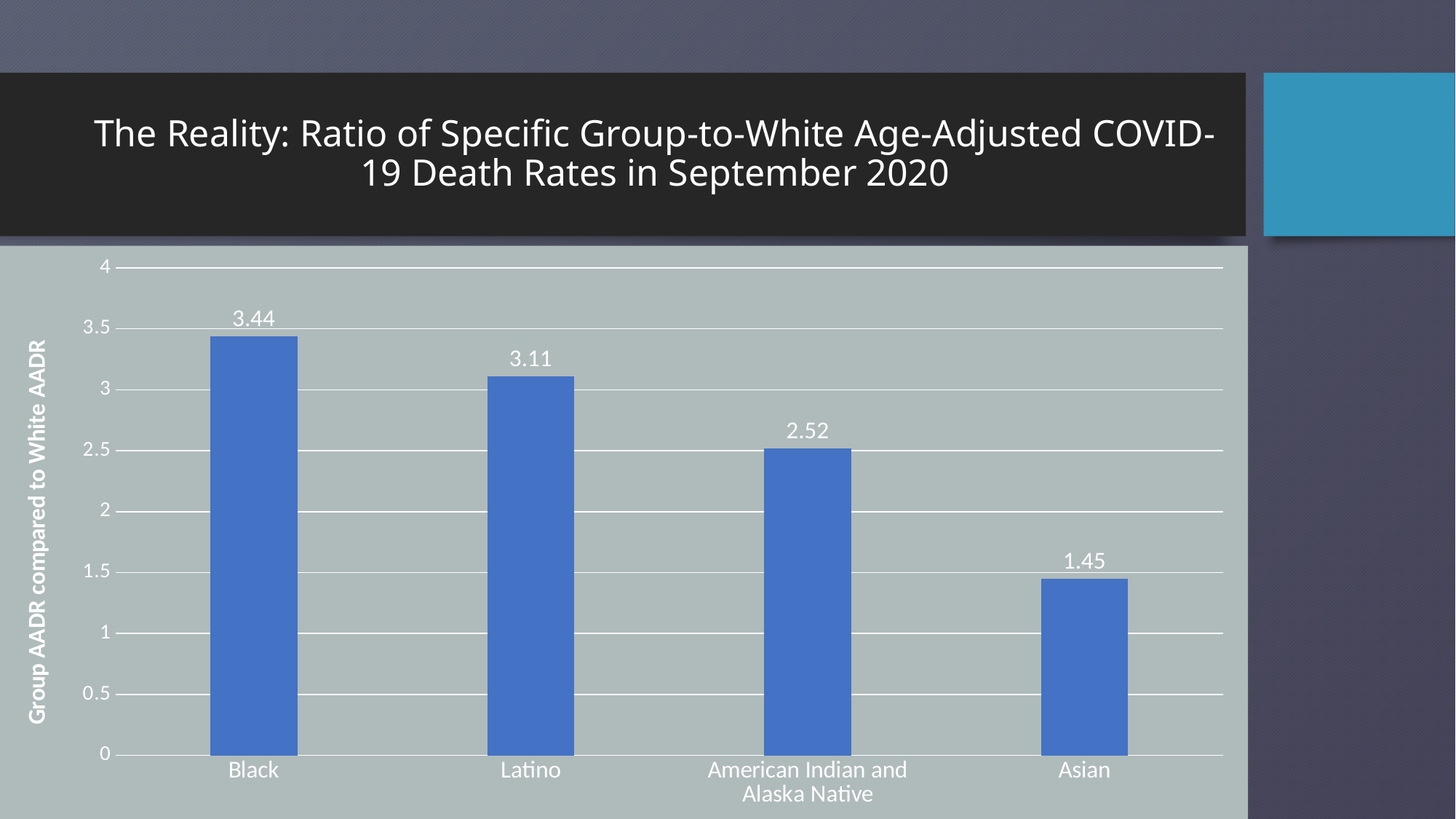
What kind of chart is shown on the slide? Bar chart What is the ratio value for Asian? 1.45 What is the difference between the ratio for American Indian and Alaska Native and the ratio for Asian? 1.07 What is the ratio value for American Indian and Alaska Native? 2.52 How many groups are shown in the chart? 4 Which group has the highest ratio? Black What is the label on the vertical axis of the chart? Group AADR compared to White AADR What is the ratio value for Latino? 3.11 What is the ratio value for Black? 3.44 Which group has the lowest ratio? Asian What is the difference between the ratio for Black and the ratio for Latino? 0.33 Which is larger, the ratio for Latino or the ratio for American Indian and Alaska Native? Latino